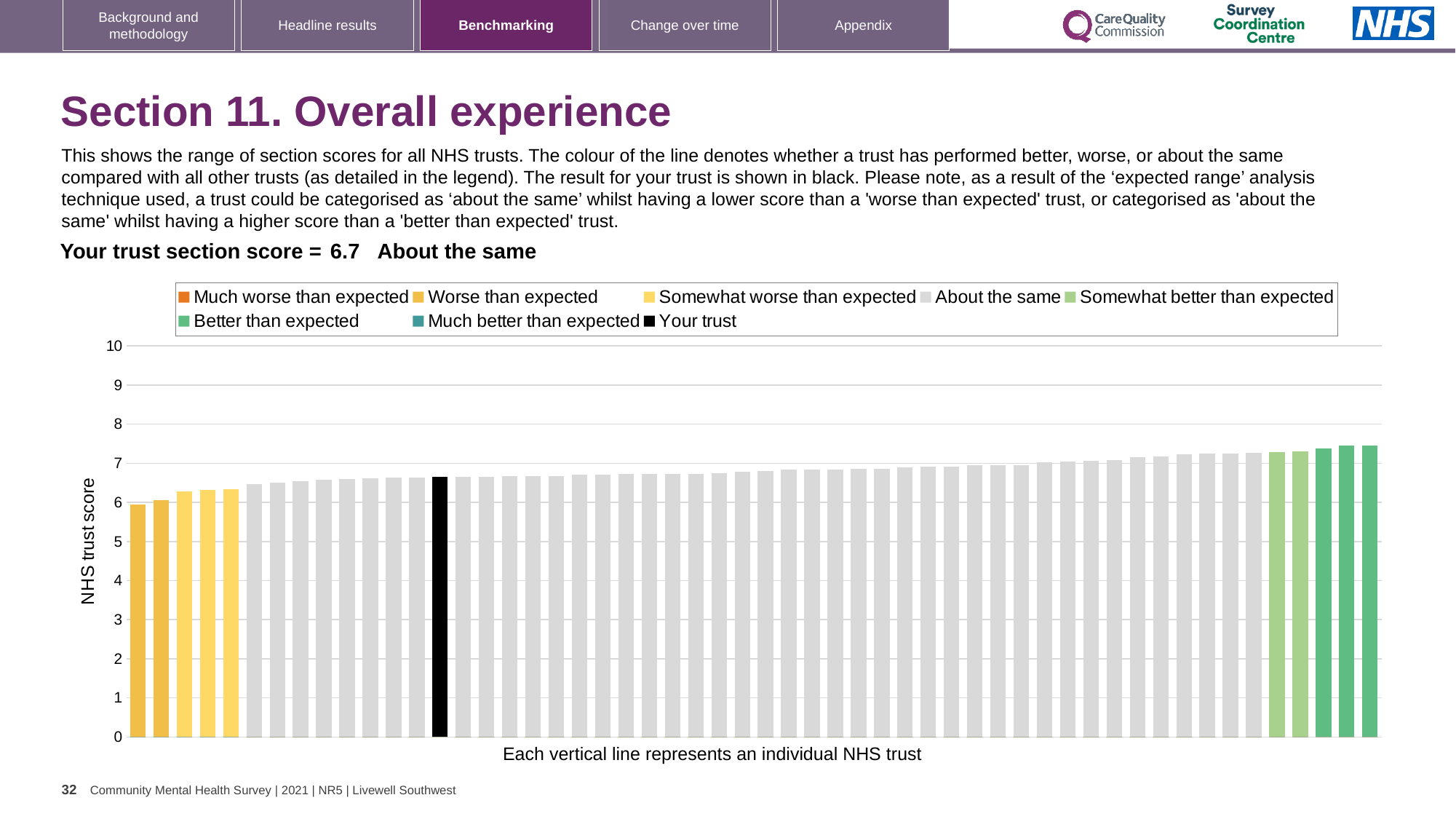
Do the trust scores rise or fall moving from left to right along the x axis? rise Which benchmarking category is your trust placed in for this section? About the same How many entries does the chart legend list? 8 Is the value of the lowest bar on the chart greater or less than 7? less Is the value of the black bar (your trust) greater or less than 6? greater Is the value of the highest bar on the chart greater or less than 8? less What is the label on the vertical axis of the chart? NHS trust score What kind of chart is shown on the slide? bar chart What is the section score for your trust shown on the chart? 6.7 What colour is used for the bar representing your trust? black